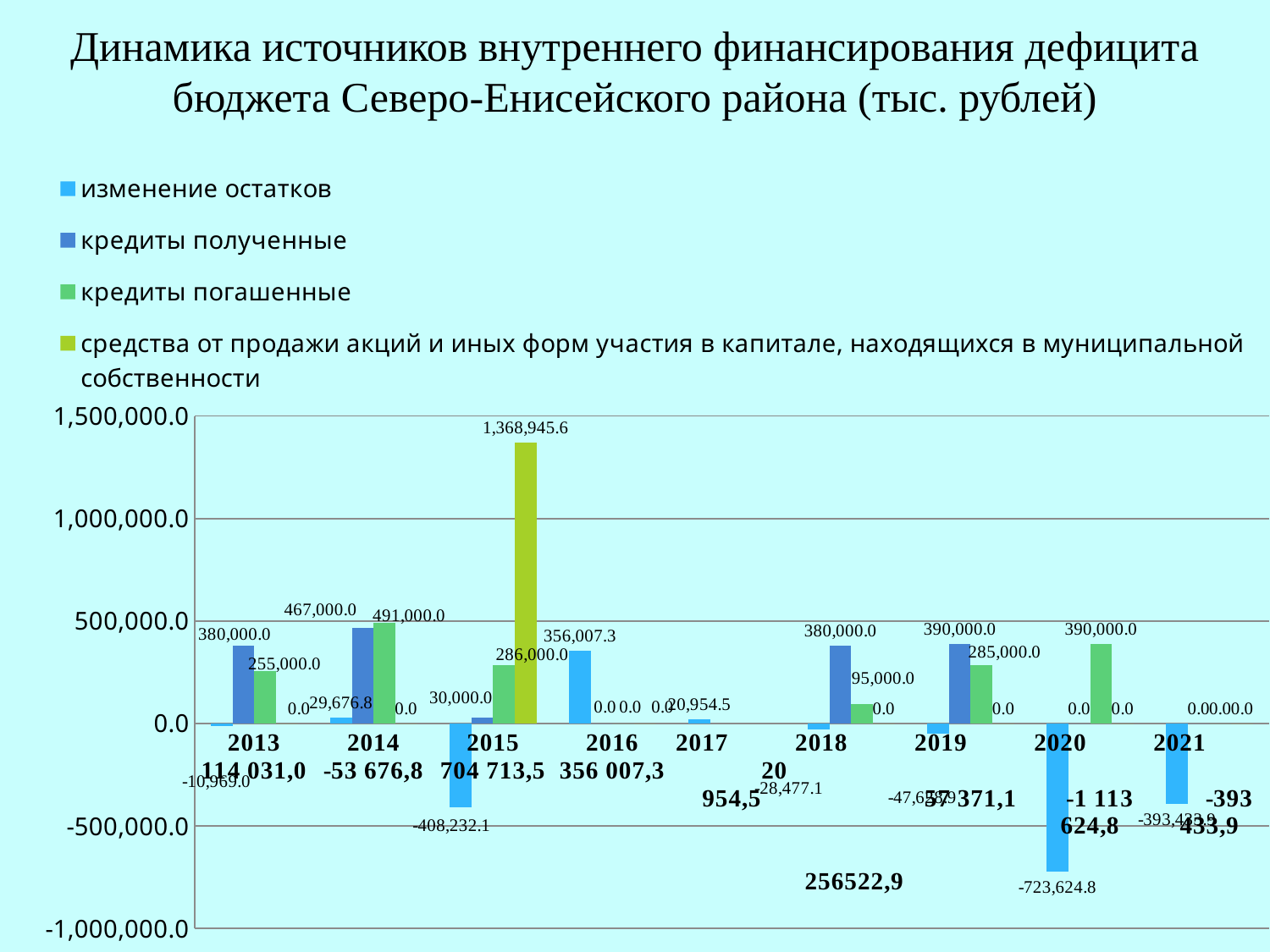
What is the value of 'кредиты погашенные' in 2020? 390,000.0 What is the value of 'средства от продажи акций и иных форм участия в капитале, находящихся в муниципальной собственности' in 2015? 1,368,945.6 What is the difference between 'кредиты погашенные' and 'кредиты полученные' in 2014? 24,000.0 How many series does the legend list? 4 In 2013, which is larger: 'кредиты полученные' or 'кредиты погашенные'? кредиты полученные In which year is 'изменение остатков' at its lowest value? 2020 What is the value of 'кредиты полученные' in 2014? 467,000.0 How many years are shown on the x axis? 9 What kind of chart is shown on the slide? bar chart What is the value of 'изменение остатков' in 2016? 356,007.3 What is the value of 'изменение остатков' in 2020? -723,624.8 In which year does the tallest bar on the chart appear? 2015